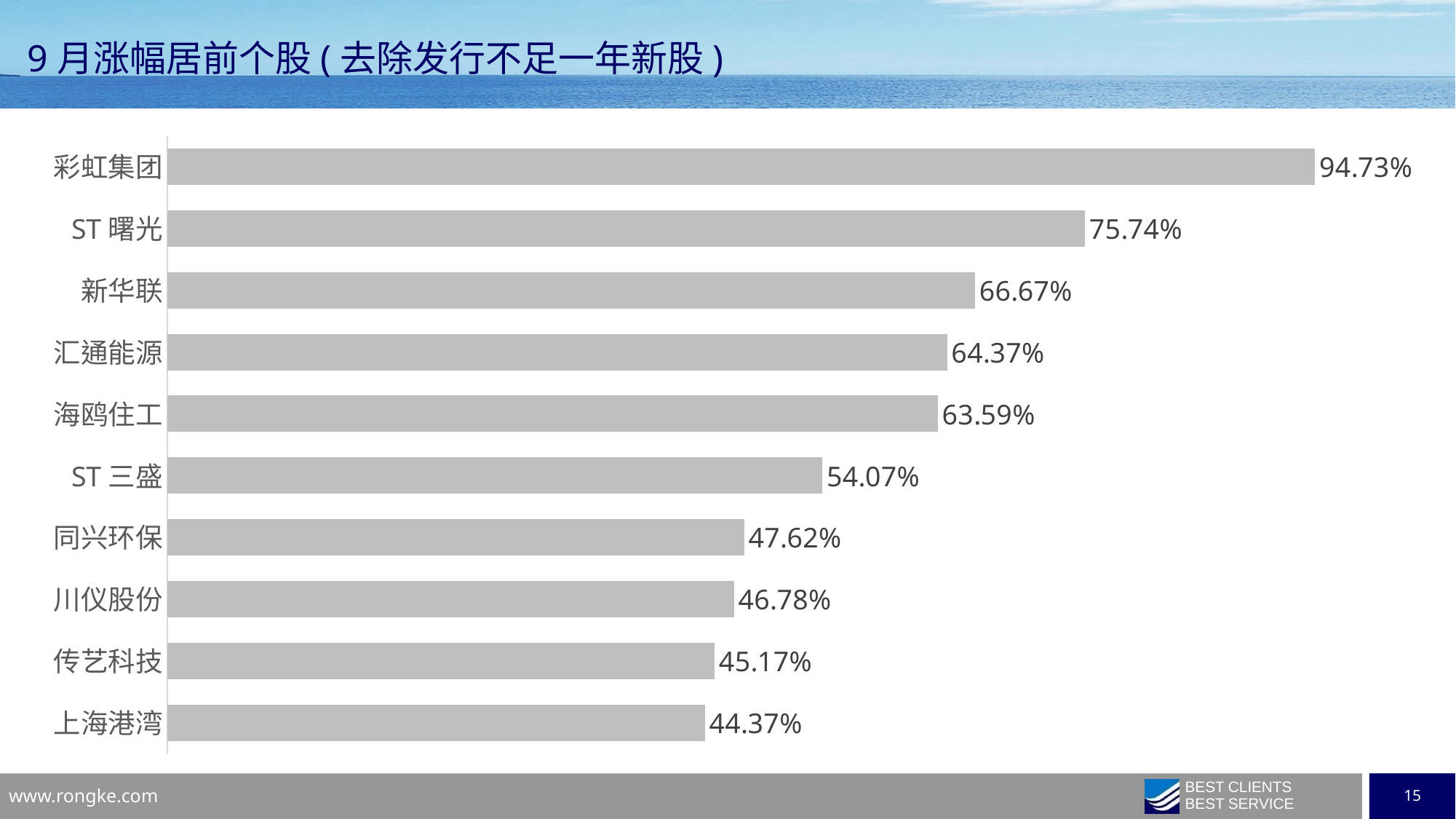
What is the value for 上海港湾? 44.37% What is the title of the chart on the slide? 9 月涨幅居前个股 ( 去除发行不足一年新股 ) What is the value for 汇通能源? 64.37% Which stock has the highest value? 彩虹集团 What is the value for 彩虹集团? 94.73% Do the values rise or fall from the top bar to the bottom bar? Fall What kind of chart is shown on the slide? Bar chart What is the difference between the values for 新华联 and 汇通能源? 2.30% Which is larger, the value for ST 三盛 or the value for 同兴环保? ST 三盛 How many stocks are shown in the chart? 10 Which stock has the lowest value? 上海港湾 What is the difference between the values for 彩虹集团 and ST 曙光? 18.99%